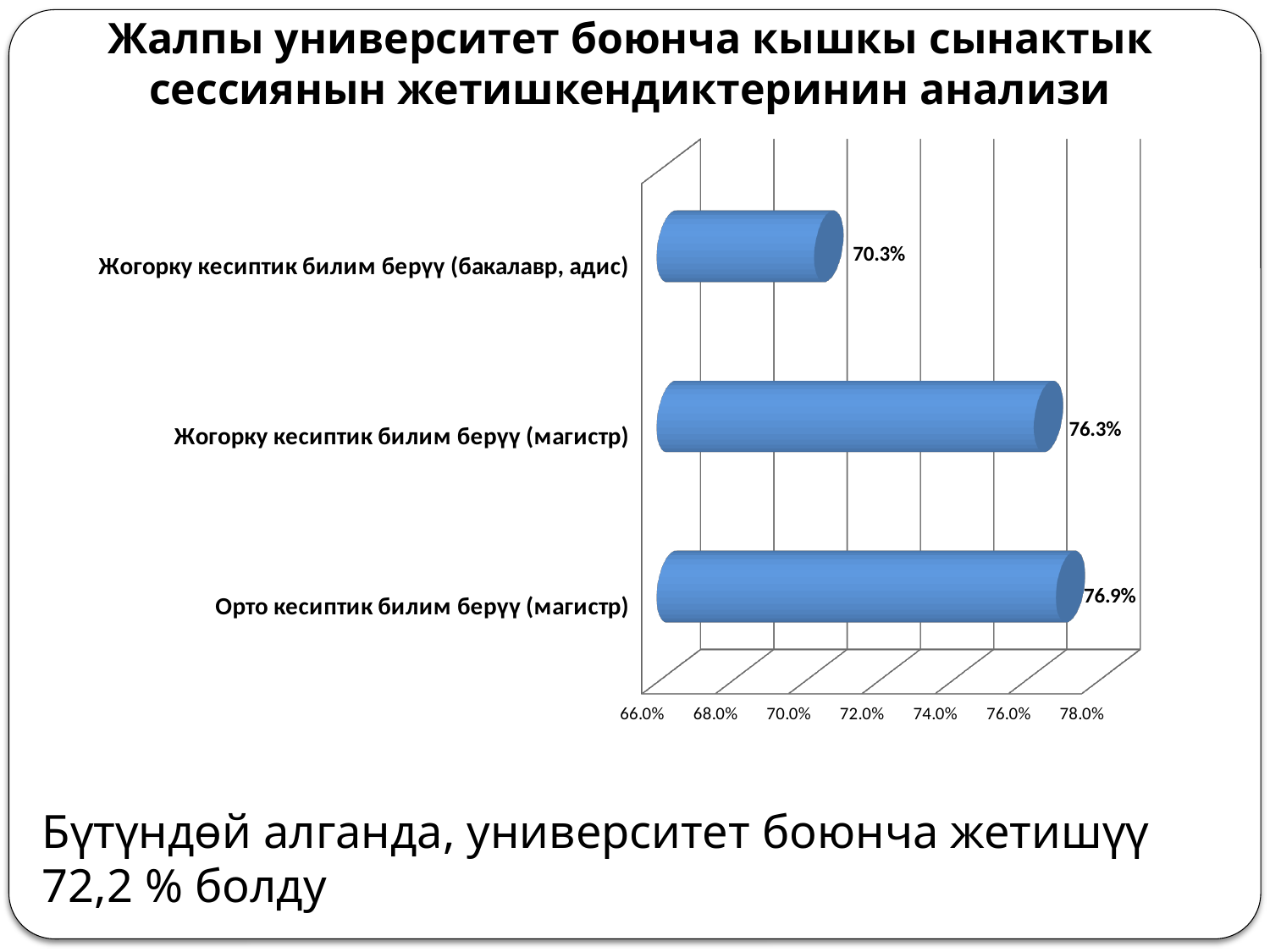
What is the difference between the values for Жогорку кесиптик билим берүү (магистр) and Жогорку кесиптик билим берүү (бакалавр, адис)? 6.0% What kind of chart is shown on the slide? bar chart What is the difference between the values for Орто кесиптик билим берүү (магистр) and Жогорку кесиптик билим берүү (бакалавр, адис)? 6.6% What is the value for Жогорку кесиптик билим берүү (бакалавр, адис)? 70.3% Is the value for Орто кесиптик билим берүү (магистр) greater or less than 76.0%? greater How many categories are shown in the chart? 3 Is the value for Жогорку кесиптик билим берүү (бакалавр, адис) greater or less than 72.0%? less What is the value for Орто кесиптик билим берүү (магистр)? 76.9% Which category has the lowest value? Жогорку кесиптик билим берүү (бакалавр, адис) What is the value for Жогорку кесиптик билим берүү (магистр)? 76.3% Which category has the highest value? Орто кесиптик билим берүү (магистр) Which is larger: the value for Жогорку кесиптик билим берүү (магистр) or the value for Жогорку кесиптик билим берүү (бакалавр, адис)? Жогорку кесиптик билим берүү (магистр)